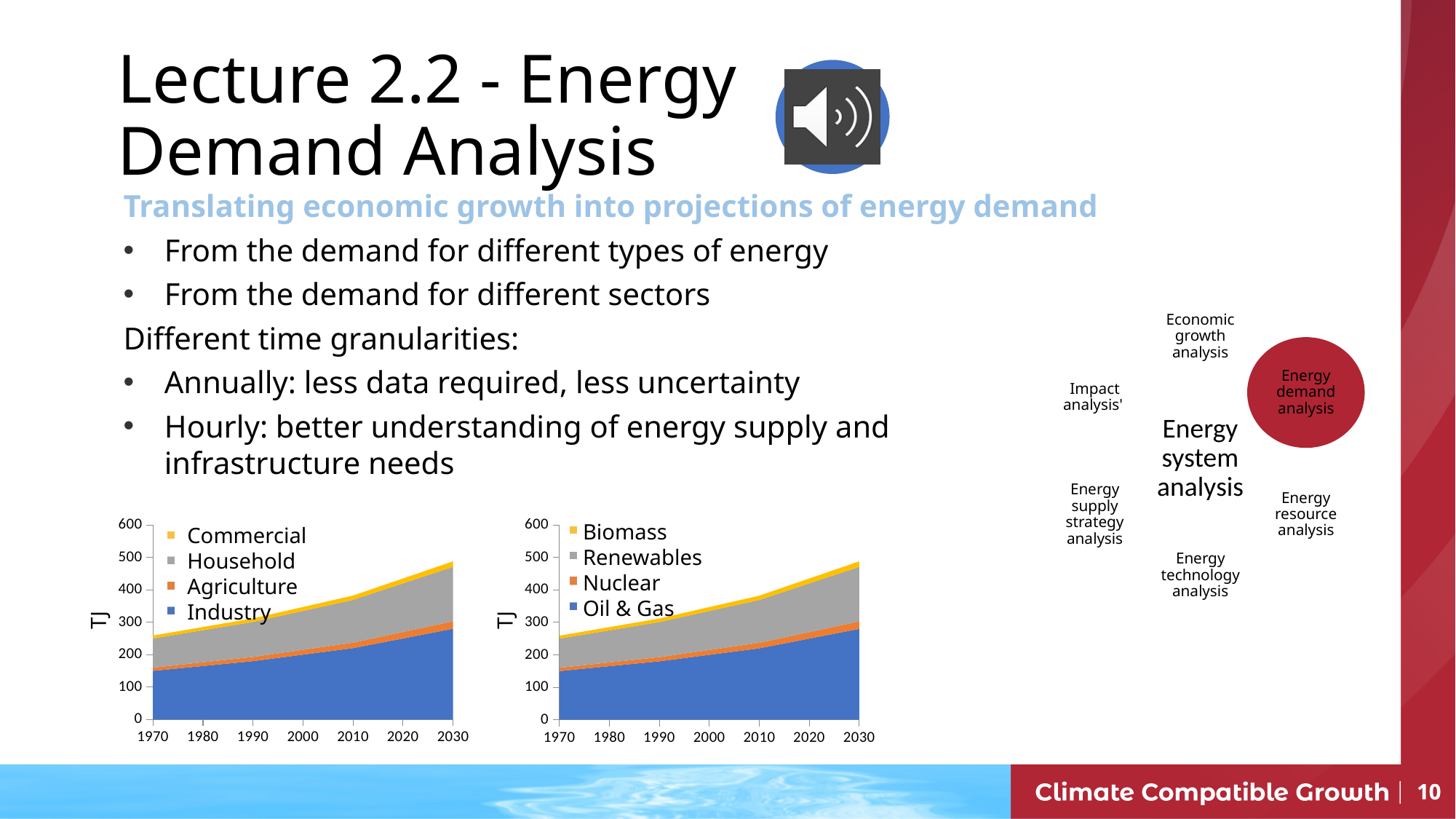
In the left chart, is the total stacked value in 2030 greater or less than 400? greater In the left chart, is the total stacked value in 1970 greater or less than 300? less In the left chart, which series occupies the largest area of the stack? Industry How many series does the legend of the left chart list? 4 In the right chart, which series is shown in blue at the bottom of the stack? Oil & Gas In the right chart, is the Oil & Gas value in 2030 greater or less than 200? greater How many series does the legend of the right chart list? 4 In the left chart, does the total stacked value rise or fall from 1970 to 2030? Rise What kind of chart is the left chart (with the Commercial, Household, Agriculture and Industry legend)? Stacked area chart In the right chart, does the total stacked value rise or fall from 1970 to 2030? Rise How many year labels are shown on the x axis of the right chart? 7 What is the label on the vertical axis of the left chart? TJ